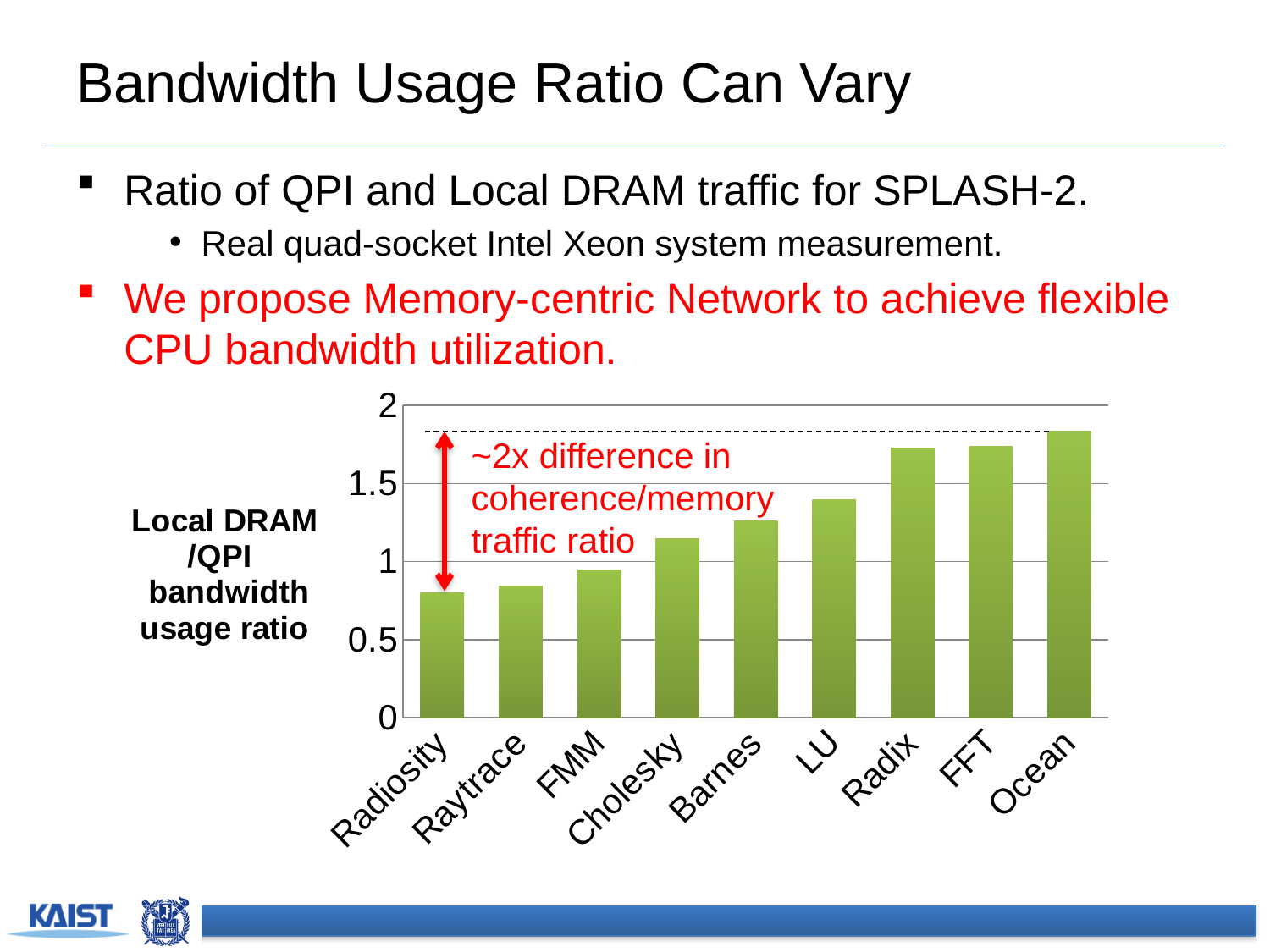
Is the value for Ocean greater or less than 1.5? greater Which has a larger bandwidth usage ratio, FMM or Radix? Radix What kind of chart is shown on the slide? bar chart Do the bar values rise or fall from left to right along the x axis? rise How many benchmarks (categories) are plotted on the x axis of the chart? 9 Is the value for Radix greater or less than 1.5? greater Which benchmark has the highest Local DRAM/QPI bandwidth usage ratio? Ocean Is the value for LU greater or less than 1.5? less What is the label on the y axis of the chart? Local DRAM /QPI bandwidth usage ratio Which has a larger bandwidth usage ratio, LU or Barnes? LU